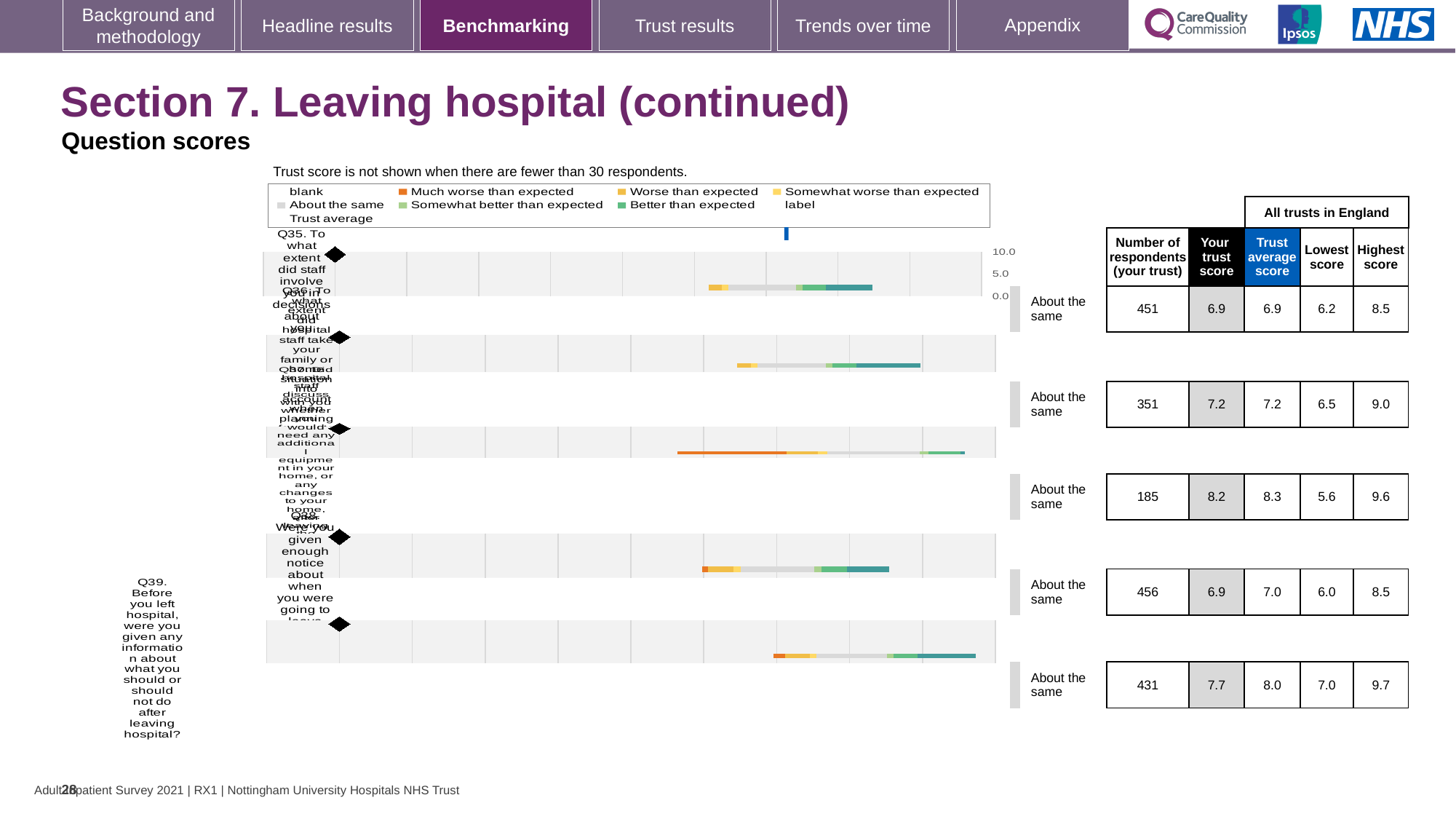
How many questions (rows) are shown in the benchmarking chart? 5 Which row has the lowest number of respondents? the third row (185 respondents) What is the difference between the trust average score and the trust score for Q39 (the last row)? 0.3 What is the trust score for Q39 (the last row)? 7.7 What is the highest score across all trusts in England for Q39 (the last row)? 9.7 What is the benchmark category shown for every question on this slide? About the same What is the lowest score in England for the third row? 5.6 What is the number of respondents for Q35 (the first row)? 451 What is the trust average score for Q39 (the last row)? 8.0 What is the difference between the highest and lowest scores in England for Q35 (the first row)? 2.3 What type of chart is used to show the question scores on this slide? bar chart Which is larger for Q35 (the first row): the trust score or the lowest score in England? the trust score (6.9)